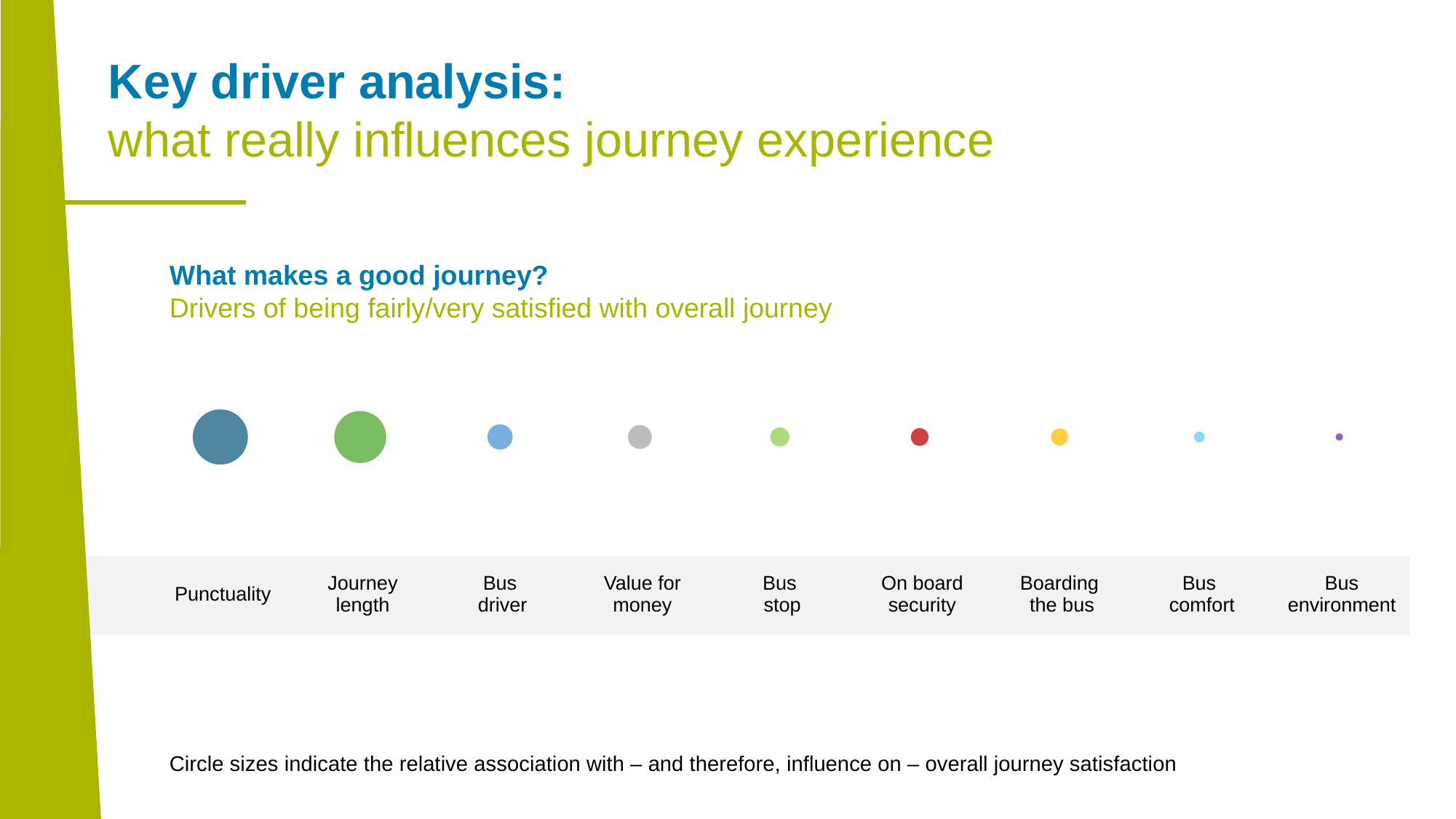
Which driver has the smallest circle? Bus environment Which has the larger circle, Punctuality or Bus driver? Punctuality Which has the larger circle, Boarding the bus or Bus environment? Boarding the bus How many drivers are shown in the chart? 9 According to the note below the chart, what do the circle sizes indicate? The relative association with – and therefore, influence on – overall journey satisfaction Which driver is listed first (leftmost) in the chart? Punctuality What kind of chart is used to show the drivers of journey satisfaction? Bubble chart Which has the larger circle, Bus driver or Bus comfort? Bus driver Do the circle sizes increase or decrease from left to right across the chart? Decrease